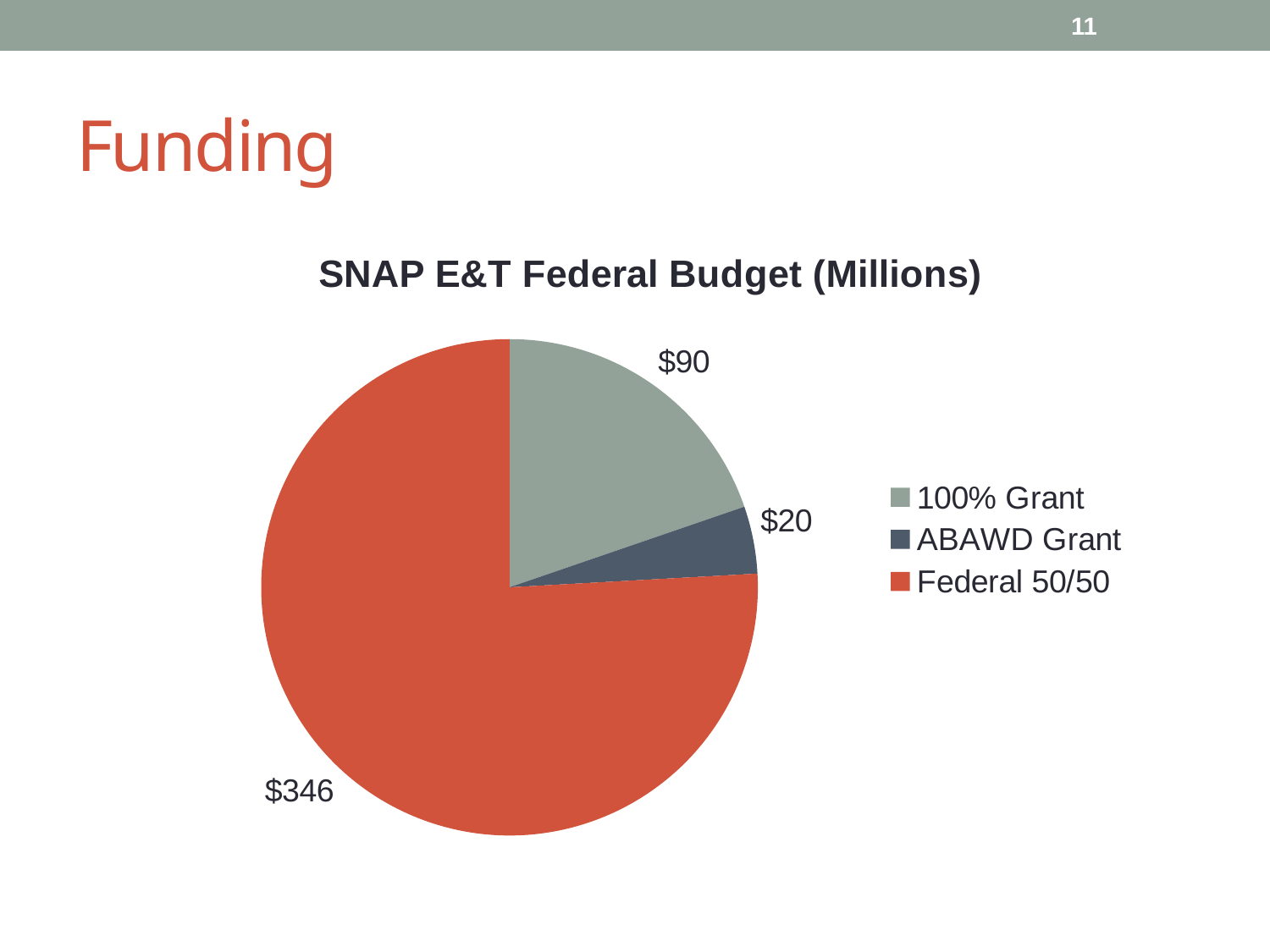
What is the value for the Federal 50/50 slice in the SNAP E&T Federal Budget pie chart? $346 What is the value for the ABAWD Grant slice? $20 How many slices does the pie chart have? 3 What is the value for the 100% Grant slice? $90 What is the difference between the Federal 50/50 value and the 100% Grant value? $256 Which is larger, the 100% Grant slice or the ABAWD Grant slice? 100% Grant What is the total of all three slices in the pie chart? $456 What type of chart is shown on the slide? Pie chart What is the difference between the 100% Grant value and the ABAWD Grant value? $70 What is the title of the chart? SNAP E&T Federal Budget (Millions) Which category has the largest slice of the pie? Federal 50/50 Which category has the smallest slice of the pie? ABAWD Grant